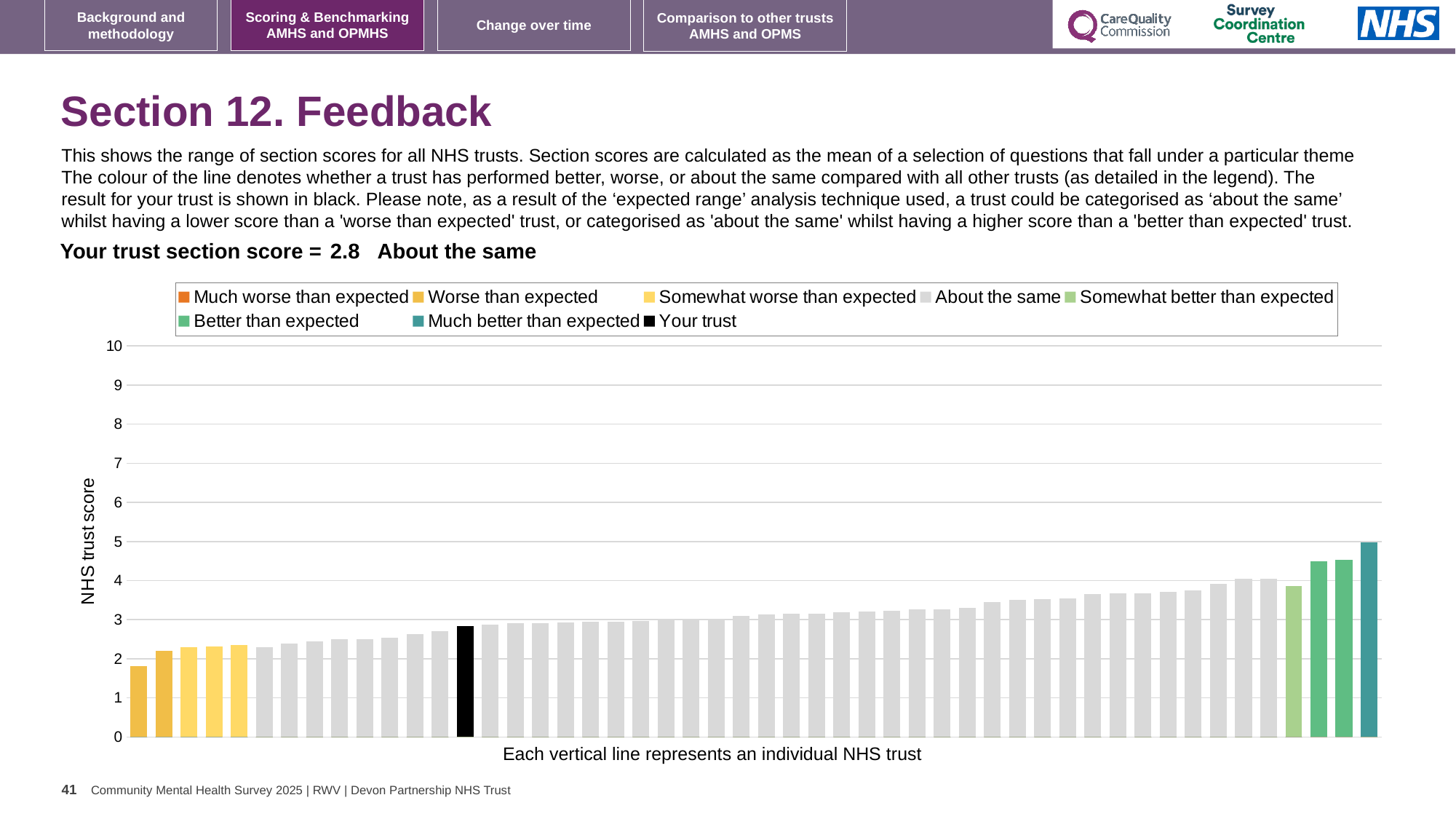
What kind of chart is shown on the slide? bar chart Which category is your trust placed in for this section? About the same Which legend category does the tallest bar belong to? Much better than expected Is the black bar for your trust higher or lower than the teal bar at the far right? lower Is the value of the shortest bar greater or less than 2? less What is the section score for your trust? 2.8 How many entries does the chart legend list? 8 Is the value of the tallest bar greater or less than 4? greater Is the value for your trust (the black bar) greater or less than 3? less How many bars are coloured as 'Better than expected' (green)? 2 Do the bar values rise or fall from left to right along the x axis? rise What is the label on the vertical axis? NHS trust score